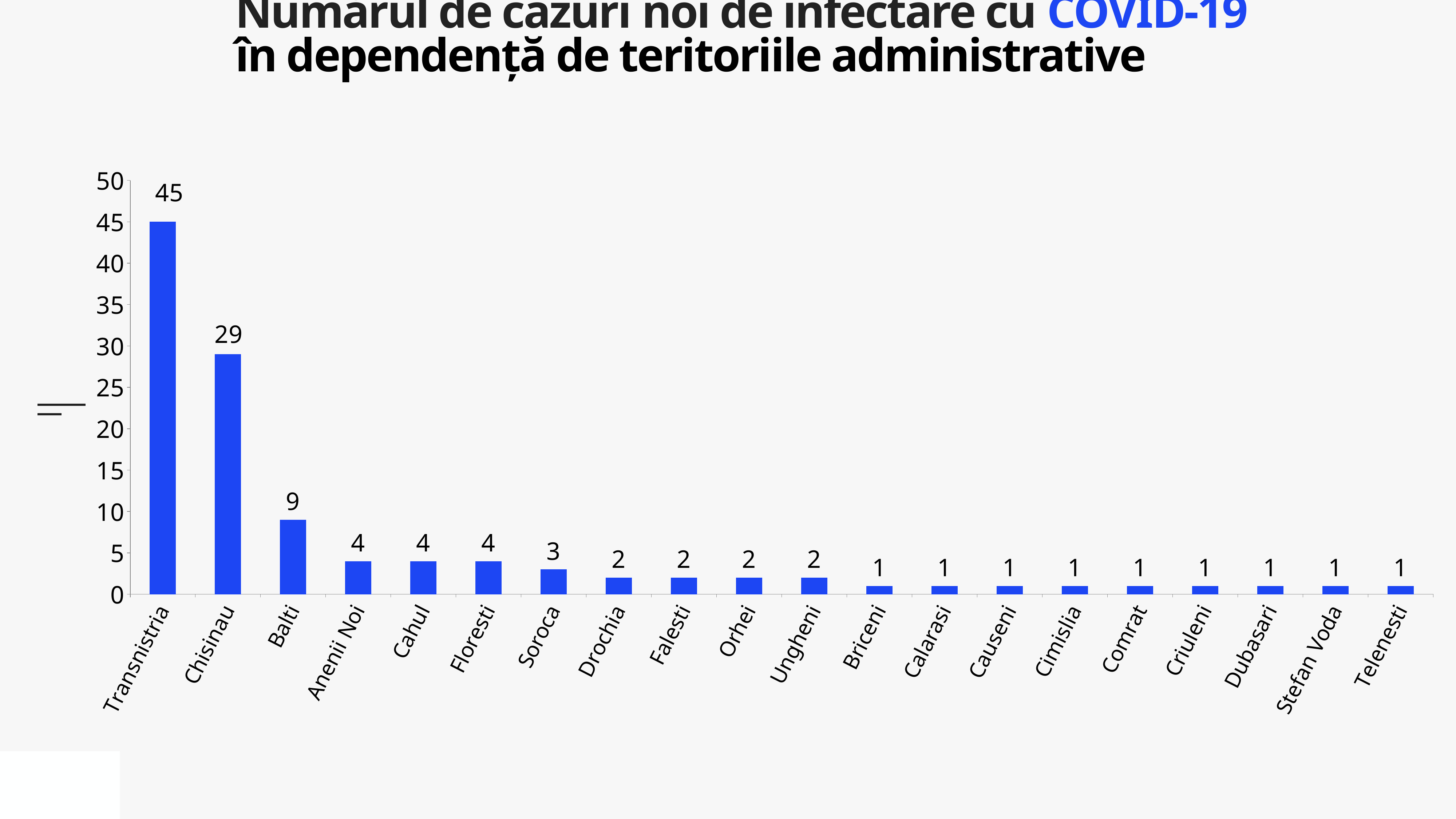
What kind of chart is shown on the slide? bar chart What is the difference between the values for Transnistria and Chisinau? 16 Is the value for Chisinau greater or less than 25? greater What is the value for Soroca? 3 How many territories are shown on the x axis? 20 What is the value for Chisinau? 29 Which territory has the highest number of new cases? Transnistria Which is larger, the value for Balti or the value for Anenii Noi? Balti What is the value for Transnistria? 45 Do the values rise or fall from left to right along the x axis? fall What is the value for Balti? 9 What is the difference between the values for Chisinau and Balti? 20